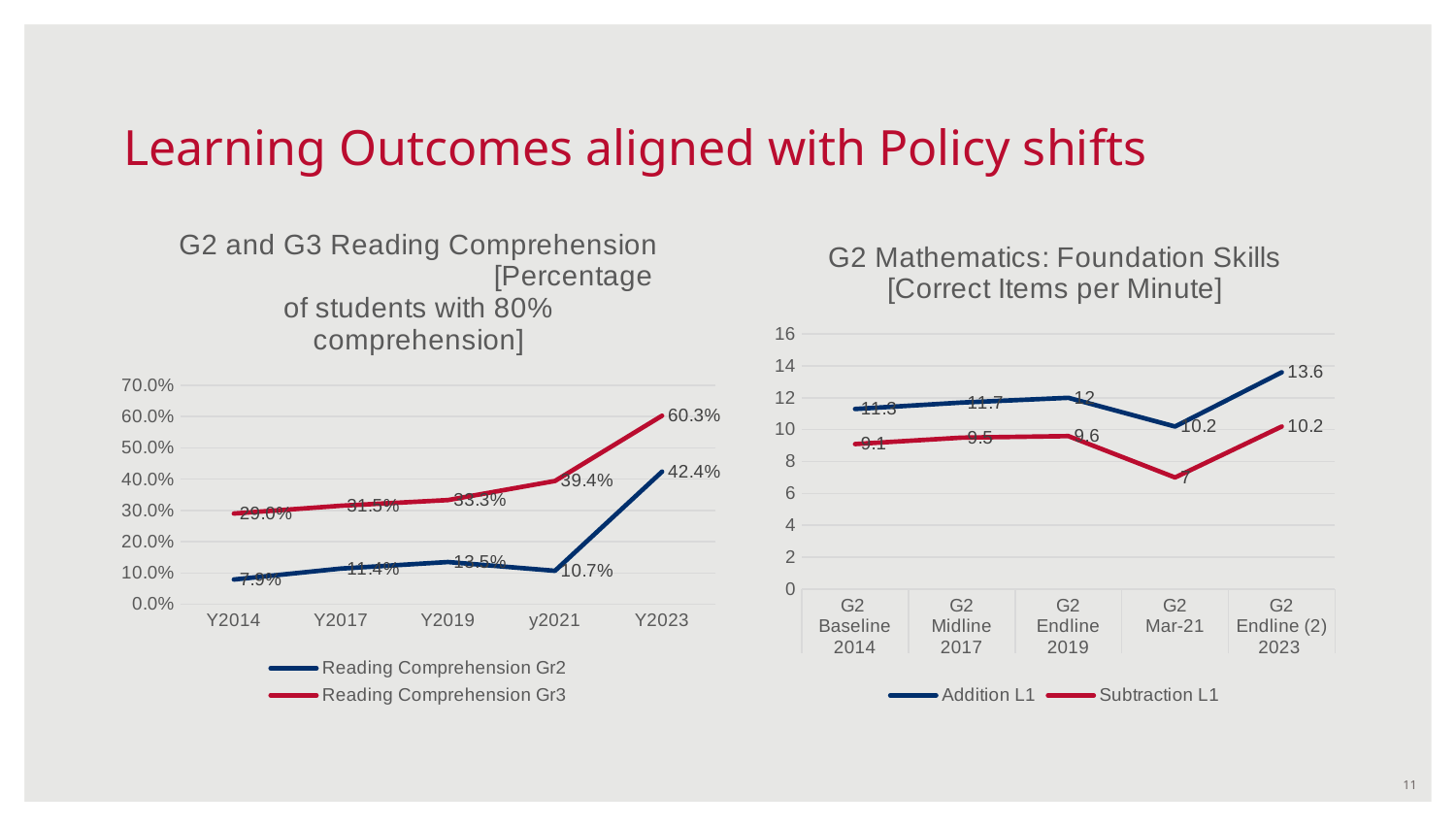
In the right chart, 'G2 Mathematics: Foundation Skills', what is the value for Addition L1 at G2 Endline 2019? 12 In the right chart, 'G2 Mathematics: Foundation Skills', at which category is Subtraction L1 lowest? G2 Mar-21 In the right chart, 'G2 Mathematics: Foundation Skills', how many series does the legend list? 2 What kind of chart is the left chart, 'G2 and G3 Reading Comprehension'? Line chart In the right chart, 'G2 Mathematics: Foundation Skills', what is the difference between Addition L1 and Subtraction L1 at G2 Endline (2) 2023? 3.4 In the left chart, 'G2 and G3 Reading Comprehension', what is the value for Reading Comprehension Gr2 at y2021? 10.7% In the left chart, 'G2 and G3 Reading Comprehension', which is larger: Reading Comprehension Gr3 at y2021 or Reading Comprehension Gr2 at Y2023? Reading Comprehension Gr2 at Y2023 In the left chart, 'G2 and G3 Reading Comprehension', what is the difference between Reading Comprehension Gr3 and Reading Comprehension Gr2 at Y2023? 17.9 percentage points How many categories are shown on the x axis of the left chart, 'G2 and G3 Reading Comprehension'? 5 In the right chart, 'G2 Mathematics: Foundation Skills', does Subtraction L1 rise or fall from G2 Mar-21 to G2 Endline (2) 2023? Rise In the right chart, 'G2 Mathematics: Foundation Skills', at which category is Addition L1 highest? G2 Endline (2) 2023 In the left chart, 'G2 and G3 Reading Comprehension', what is the value for Reading Comprehension Gr3 at Y2023? 60.3%